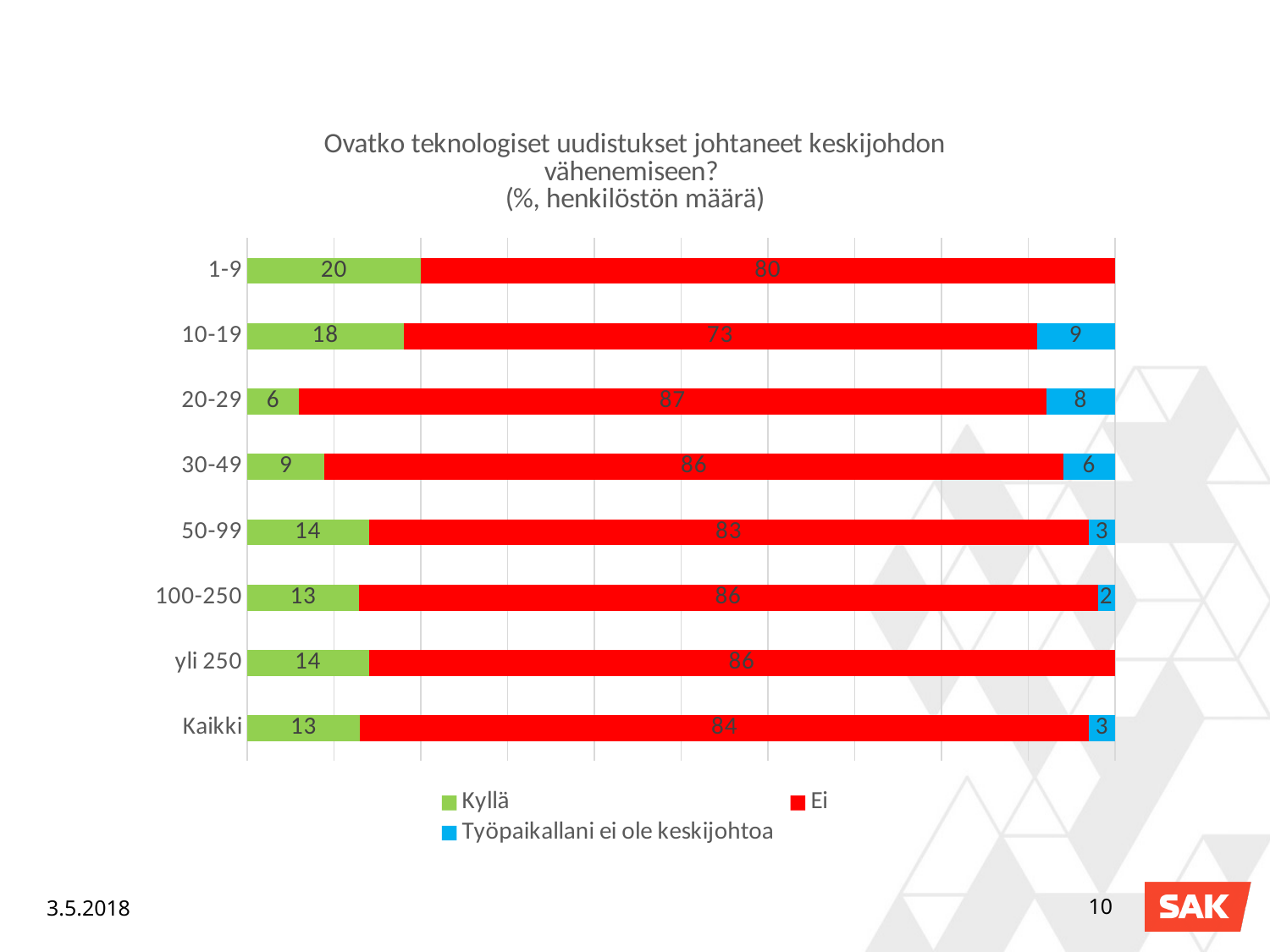
Which category has the highest Ei value? 20-29 Which is larger, the Kyllä value for 10-19 or the Kyllä value for 30-49? 10-19 What is the Ei value for the Kaikki category? 84 What kind of chart is shown on the slide? Stacked bar chart What is the Työpaikallani ei ole keskijohtoa value for the 20-29 category? 8 Which category has the highest Kyllä value? 1-9 What is the difference between the Ei values for 20-29 and 10-19? 14 What is the Ei value for the 10-19 category? 73 How many categories are shown on the y axis? 8 Which category has the lowest Kyllä value? 20-29 How many series does the legend list? 3 What is the Kyllä value for the 1-9 category? 20